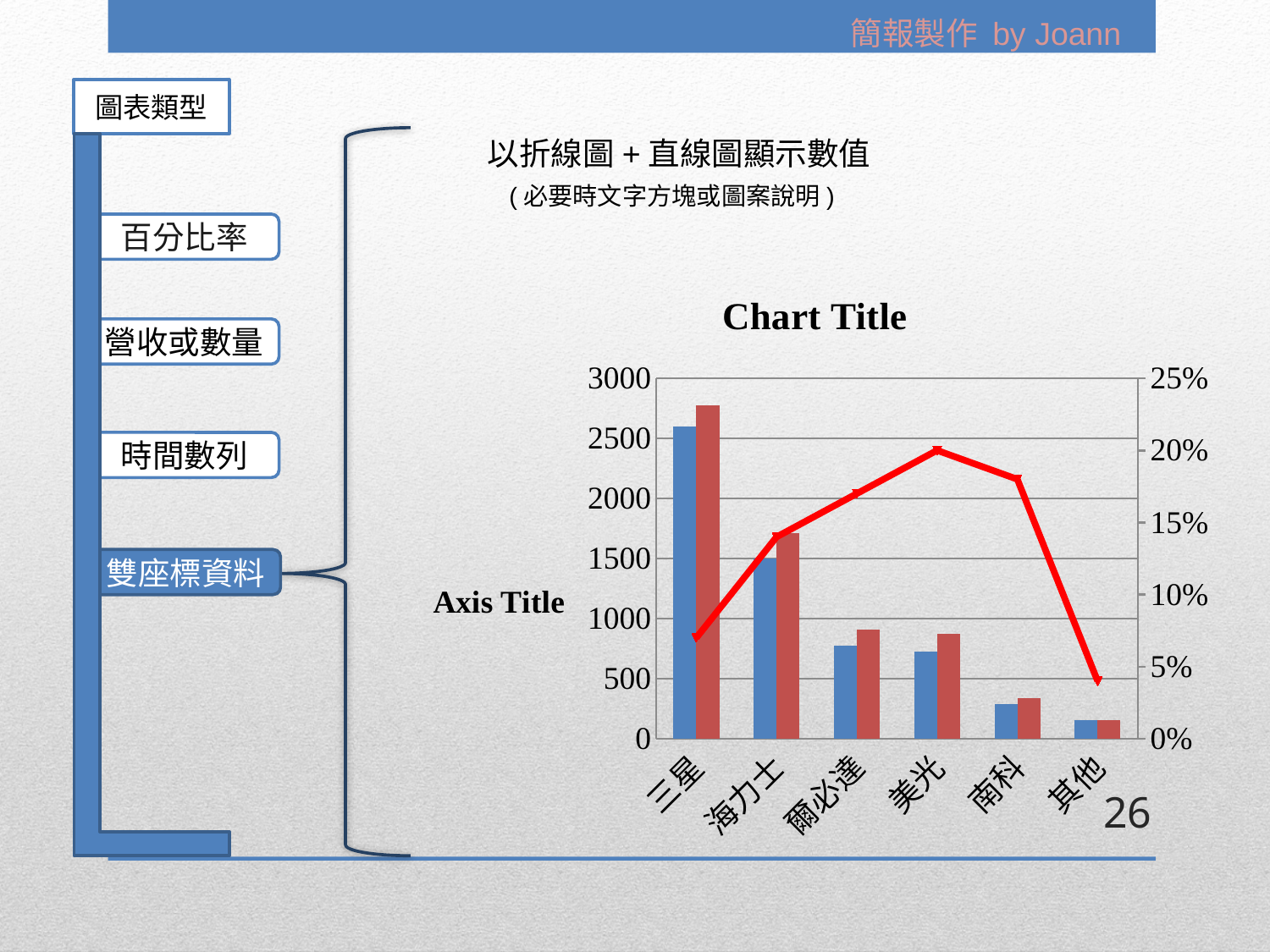
Is the red line value for 美光 greater or less than 15% on the right axis? greater Which category has a taller blue bar, 海力士 or 爾必達? 海力士 Is the blue bar for 三星 greater or less than 2500 on the left axis? greater What is the title of the chart? Chart Title Is the blue bar for 海力士 greater or less than 2000 on the left axis? less Which category has the shortest bars in the chart? 其他 How many categories are shown on the x axis of the chart? 6 What kind of chart is shown on the slide? Combined bar and line chart Which category has the tallest bars in the chart? 三星 At which category does the red line reach its highest point? 美光 What is the label of the left vertical axis? Axis Title